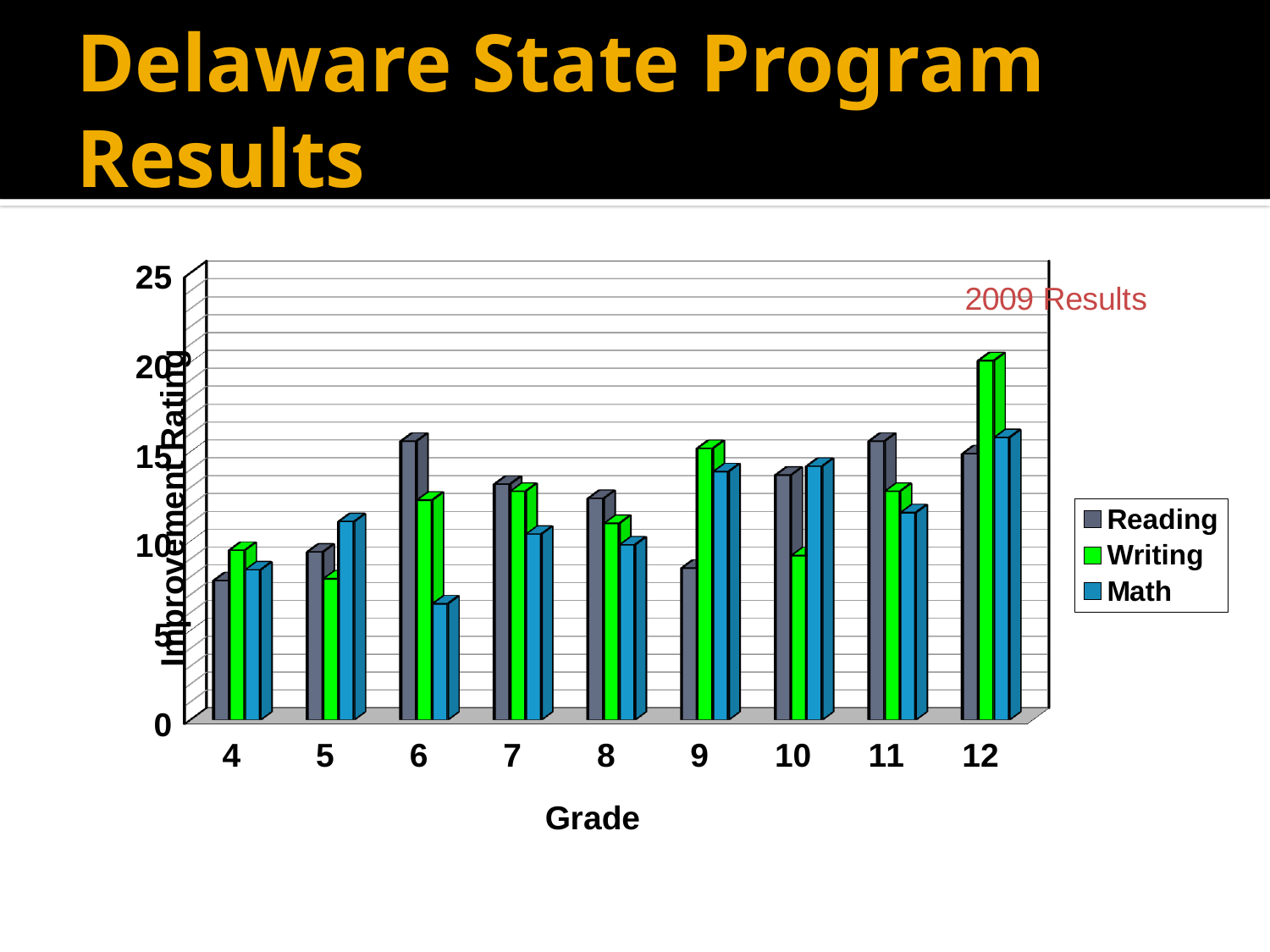
At grade 6, which is larger, Reading or Math? Reading Is the Reading value for grade 4 greater or less than 10? less For which grade is the Math value lowest? 6 At grade 9, which is larger, Reading or Writing? Writing How many grades are shown along the x axis? 9 Is the Writing value for grade 12 greater or less than 15? greater What kind of chart is shown on the slide? bar chart What is the label of the vertical axis? Improvement Rating Is the Math value for grade 6 greater or less than 10? less Which series are listed in the legend? Reading, Writing, Math For which grade is the Writing value highest? 12 How many series does the legend list? 3